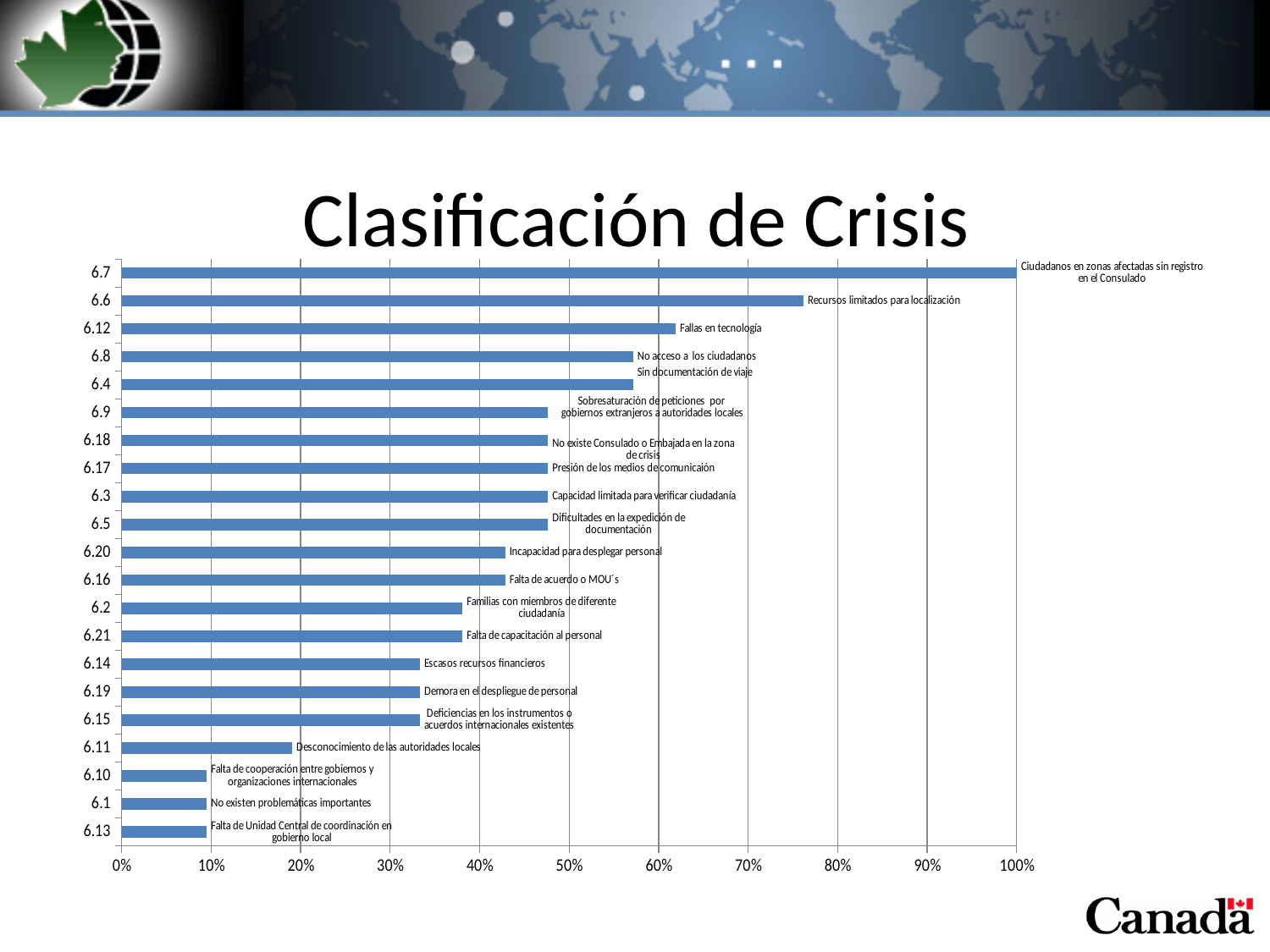
Is the value for 6.11 greater or less than 20%? less Which category has the highest value? 6.7 Which has a larger value, 6.6 or 6.12? 6.6 Which has a larger value, 6.14 or 6.11? 6.14 Is the value for 6.12 greater or less than 60%? greater Is the value for 6.6 greater or less than 70%? greater How many categories (bars) does the chart show? 21 What is the value for category 6.7? 100% What is the title of the chart? Clasificación de Crisis What kind of chart is shown on the slide? bar chart What text label is attached to the bar for category 6.7? Ciudadanos en zonas afectadas sin registro en el Consulado